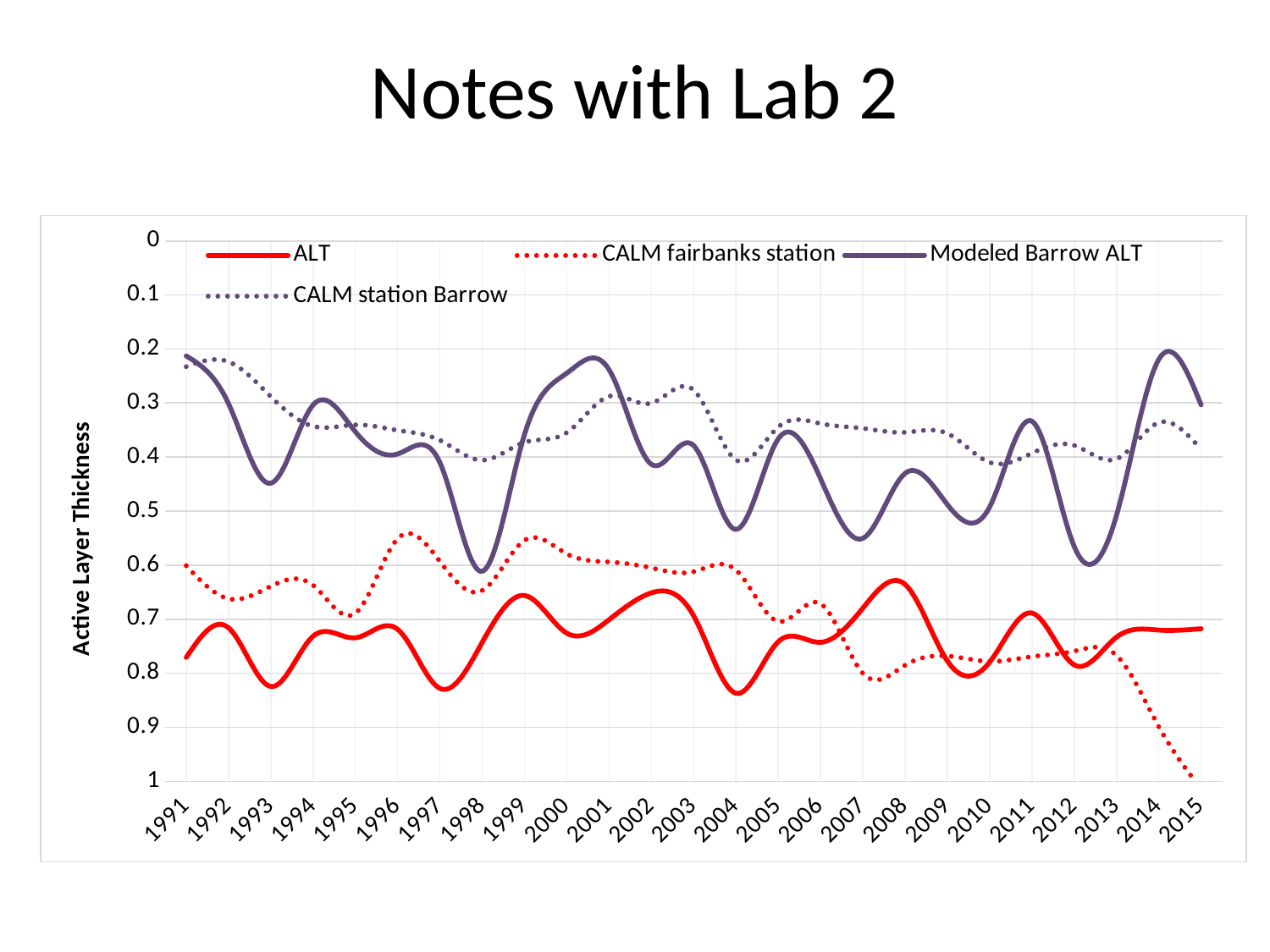
What kind of chart is shown on the slide? line chart What is the label of the vertical axis? Active Layer Thickness Which series is drawn as a solid red line? ALT In which year does the CALM fairbanks station series reach its highest value? 2015 How many series does the legend list? 4 In 2015, which series has the larger value, ALT or CALM fairbanks station? CALM fairbanks station Is the value for Modeled Barrow ALT in 2001 greater or less than 0.3? less How many years are plotted along the x axis? 25 Is the value for ALT in 2004 greater or less than 0.8? greater Is the value for Modeled Barrow ALT in 1998 greater or less than 0.5? greater